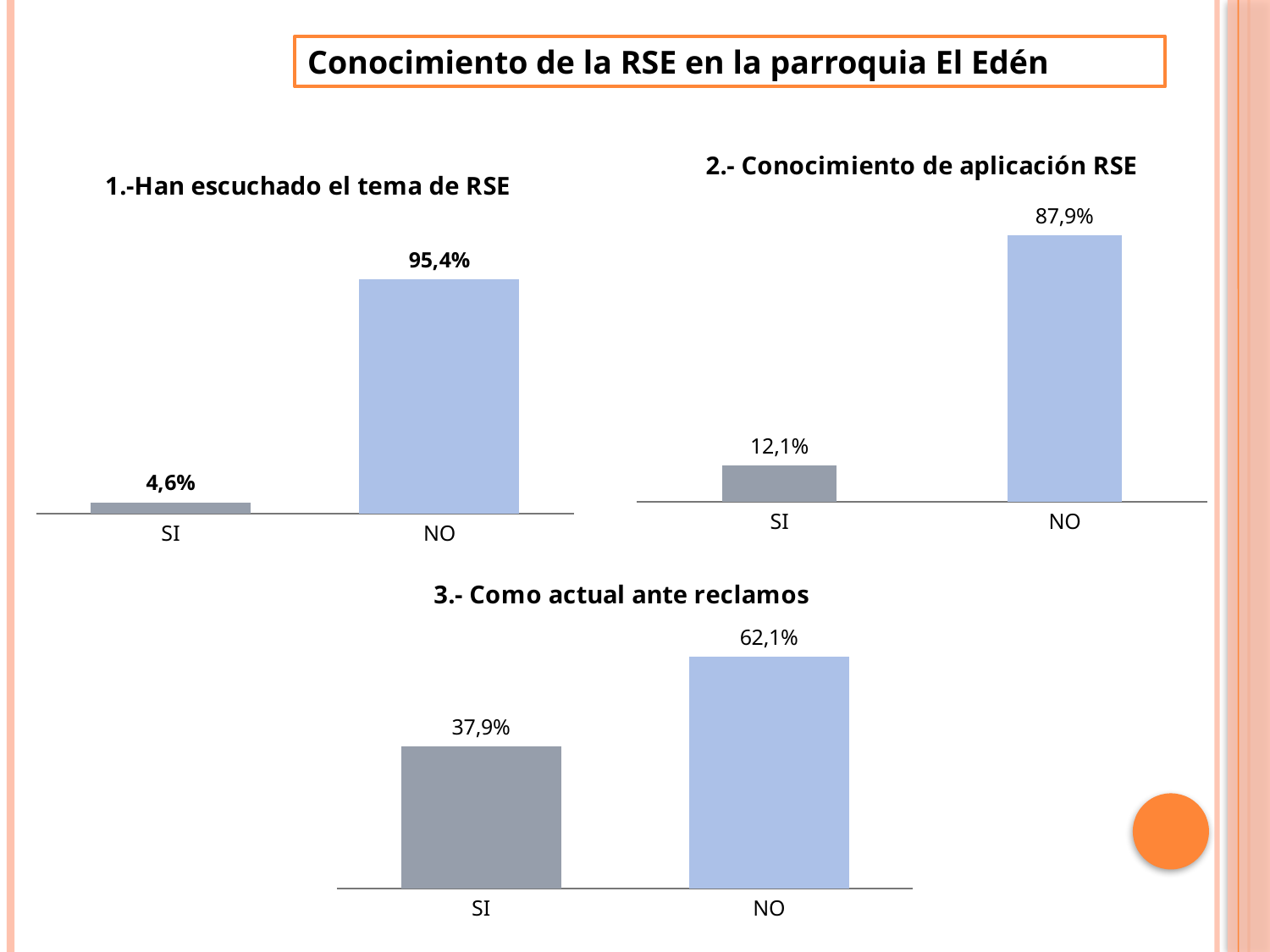
How many categories does the chart '3.- Como actual ante reclamos' show? 2 In the chart '3.- Como actual ante reclamos', which category has the highest value? NO In the chart '1.-Han escuchado el tema de RSE', what is the value for SI? 4,6% In the chart '2.- Conocimiento de aplicación RSE', what is the value for NO? 87,9% In the chart '2.- Conocimiento de aplicación RSE', what is the difference between the NO and SI values? 75,8% In the chart '3.- Como actual ante reclamos', what is the difference between the NO and SI values? 24,2% In the chart '1.-Han escuchado el tema de RSE', what is the value for NO? 95,4% In the chart '2.- Conocimiento de aplicación RSE', what is the value for SI? 12,1% In the chart '2.- Conocimiento de aplicación RSE', which is larger, SI or NO? NO In the chart '1.-Han escuchado el tema de RSE', which category has the lowest value? SI What type of chart is '1.-Han escuchado el tema de RSE'? Bar chart In the chart '3.- Como actual ante reclamos', what is the value for SI? 37,9%